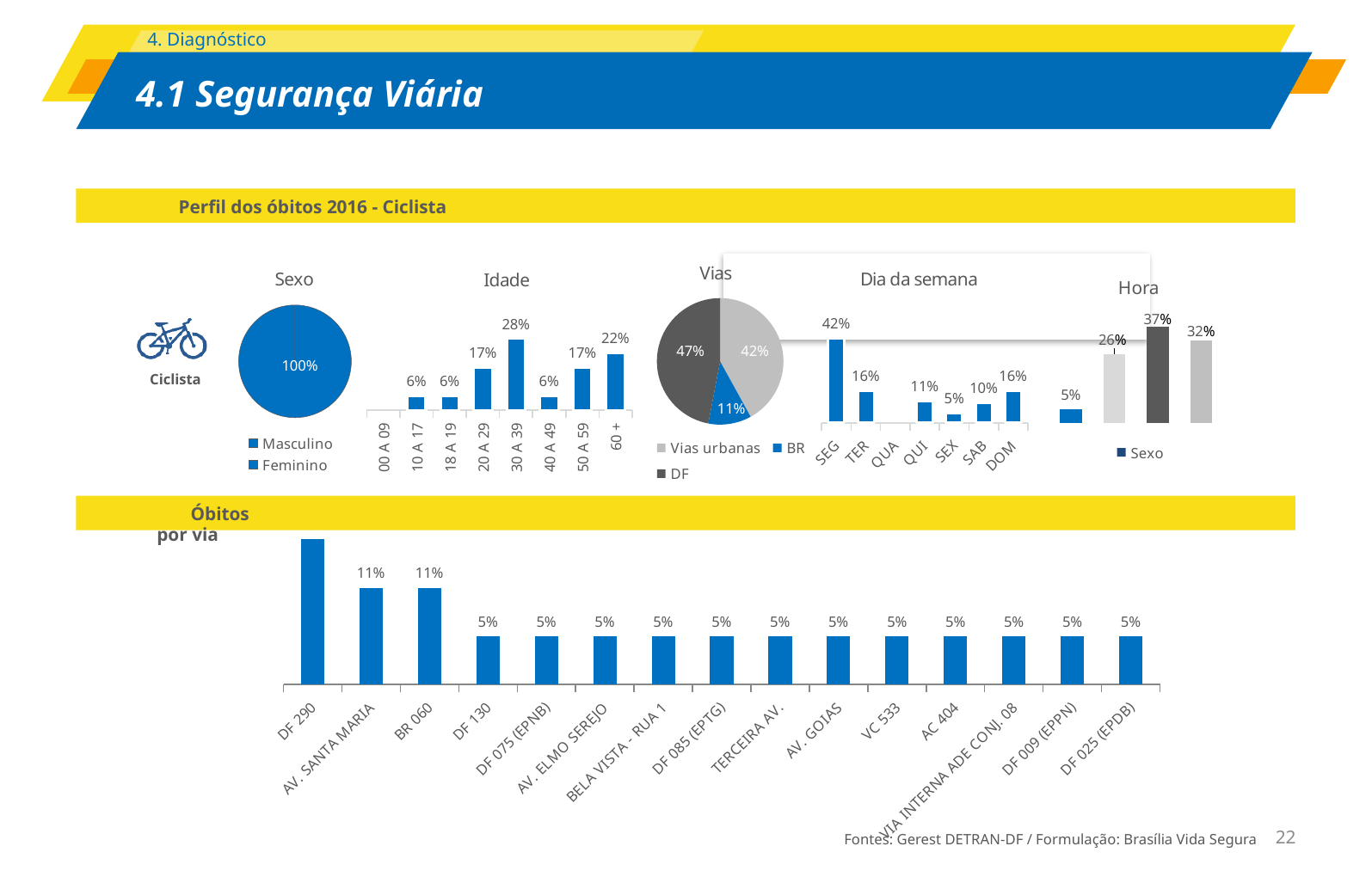
In the 'Vias' pie chart, which category has the smallest slice? BR In the 'Vias' pie chart, what share does DF have? 47% In the 'Dia da semana' chart, what is the value for SEG? 42% In the 'Idade' chart, what is the value for the 30 A 39 age group? 28% In the 'Idade' chart, what is the difference between the values for 60 + and 50 A 59? 5% In the 'Dia da semana' chart, which is larger, the value for TER or the value for QUI? TER In the 'Óbitos por via' chart, which road has the highest value? DF 290 What kind of chart is the 'Sexo' chart? Pie chart In the 'Óbitos por via' chart, what is the value for AV. SANTA MARIA? 11% In the 'Idade' chart, which age group has the highest value? 30 A 39 In the 'Dia da semana' chart, what is the difference between the values for SEG and DOM? 26% In the 'Hora' chart, what is the highest value shown? 37%